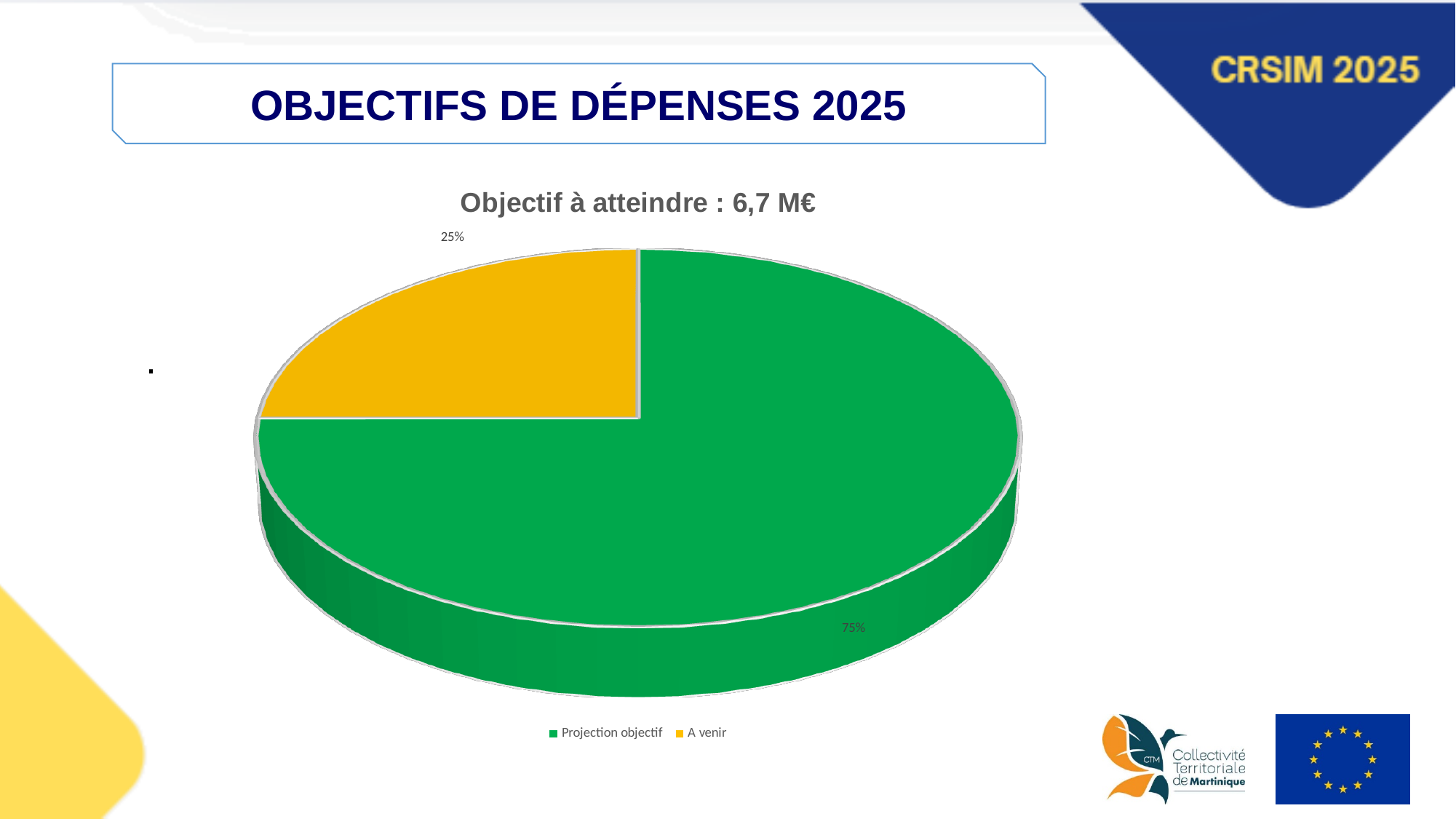
Which is larger, the 'Projection objectif' slice or the 'A venir' slice? Projection objectif What is the difference in percentage points between the 'Projection objectif' slice and the 'A venir' slice? 50 Which slice is the largest in the pie chart? Projection objectif What is the title of the chart? Objectif à atteindre : 6,7 M€ What kind of chart is shown on the slide? pie chart How many entries does the legend list? 2 Which slice is the smallest in the pie chart? A venir What colour is the 'A venir' slice? yellow How many slices does the pie chart have? 2 What share of the pie does the 'A venir' slice represent? 25% What share of the pie does the 'Projection objectif' slice represent? 75%